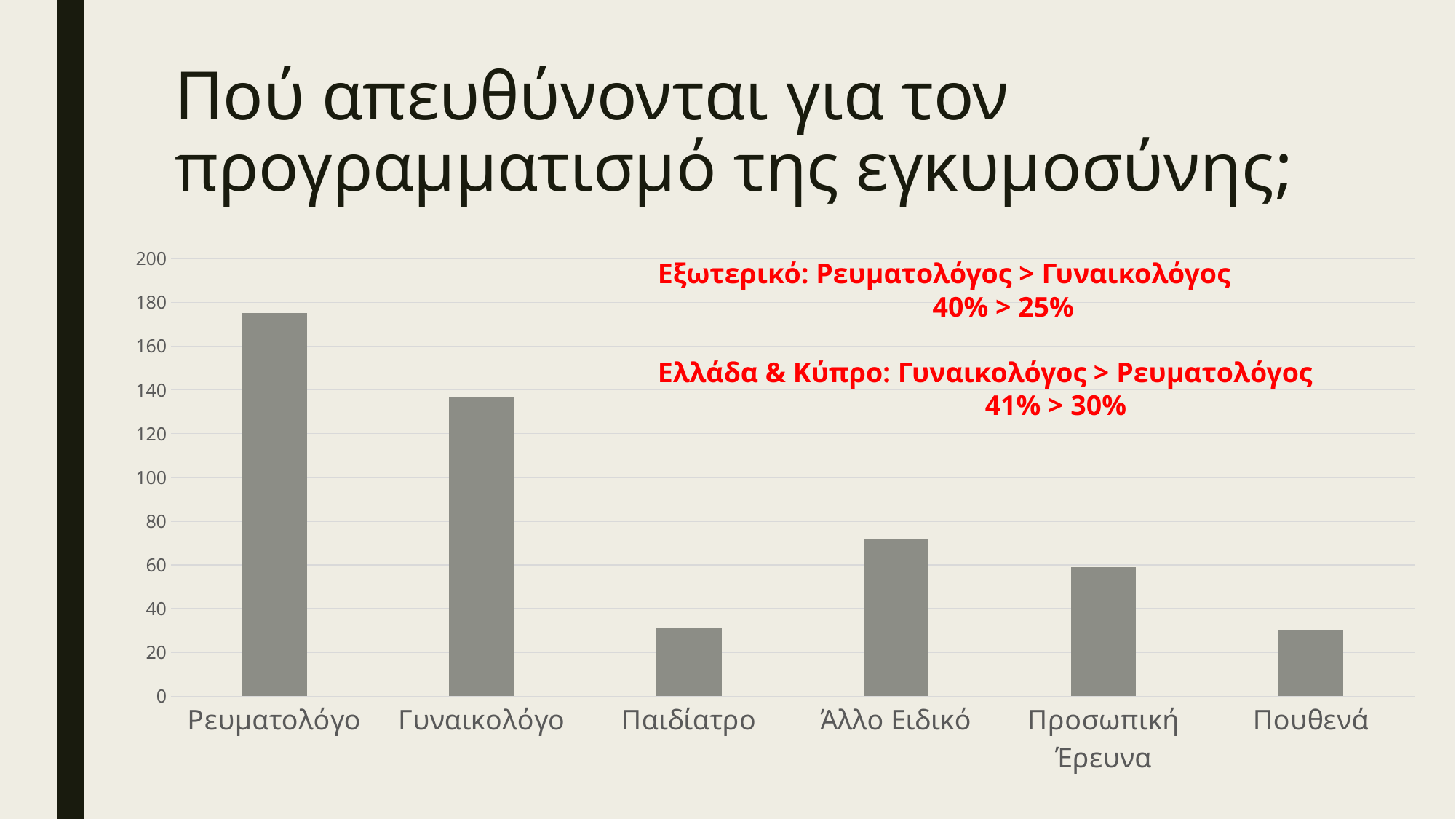
Is the value for Ρευματολόγο greater or less than 160? greater Is the value for Άλλο Ειδικό greater or less than 60? greater Which is larger, the value for Γυναικολόγο or the value for Άλλο Ειδικό? Γυναικολόγο Is the value for Προσωπική Έρευνα greater or less than 80? less Which category has the highest bar in the chart? Ρευματολόγο How many categories are shown on the x axis of the chart? 6 Which is larger, the value for Άλλο Ειδικό or the value for Προσωπική Έρευνα? Άλλο Ειδικό What kind of chart is shown on the slide? bar chart What is the highest value shown on the chart's vertical axis? 200